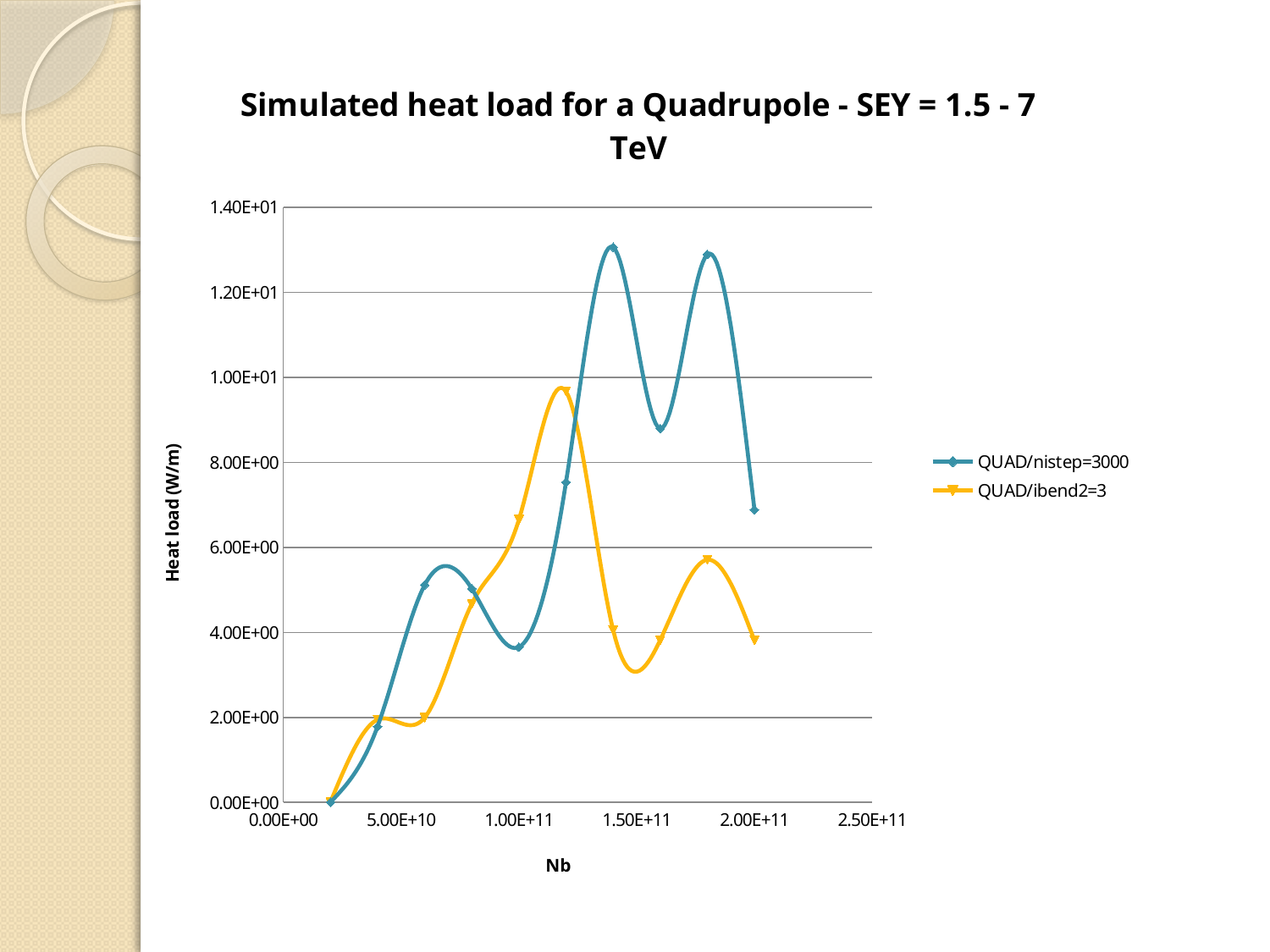
What kind of chart is shown on the slide? line chart Which series has the larger value at Nb = 1.80E+11, QUAD/nistep=3000 or QUAD/ibend2=3? QUAD/nistep=3000 Which series has the larger value at Nb = 1.20E+11, QUAD/nistep=3000 or QUAD/ibend2=3? QUAD/ibend2=3 How many data points are plotted for the QUAD/nistep=3000 series? 10 What is the title of the chart? Simulated heat load for a Quadrupole - SEY = 1.5 - 7 TeV What is the label of the vertical axis? Heat load (W/m) Is the value for QUAD/nistep=3000 at Nb = 1.00E+11 greater or less than 4.00E+00? less Is the value for QUAD/nistep=3000 at Nb = 1.40E+11 greater or less than 1.20E+01? greater Which series reaches the highest heat load anywhere on the chart? QUAD/nistep=3000 How many series does the legend list? 2 Is the value for QUAD/ibend2=3 at Nb = 1.20E+11 greater or less than 1.00E+01? less